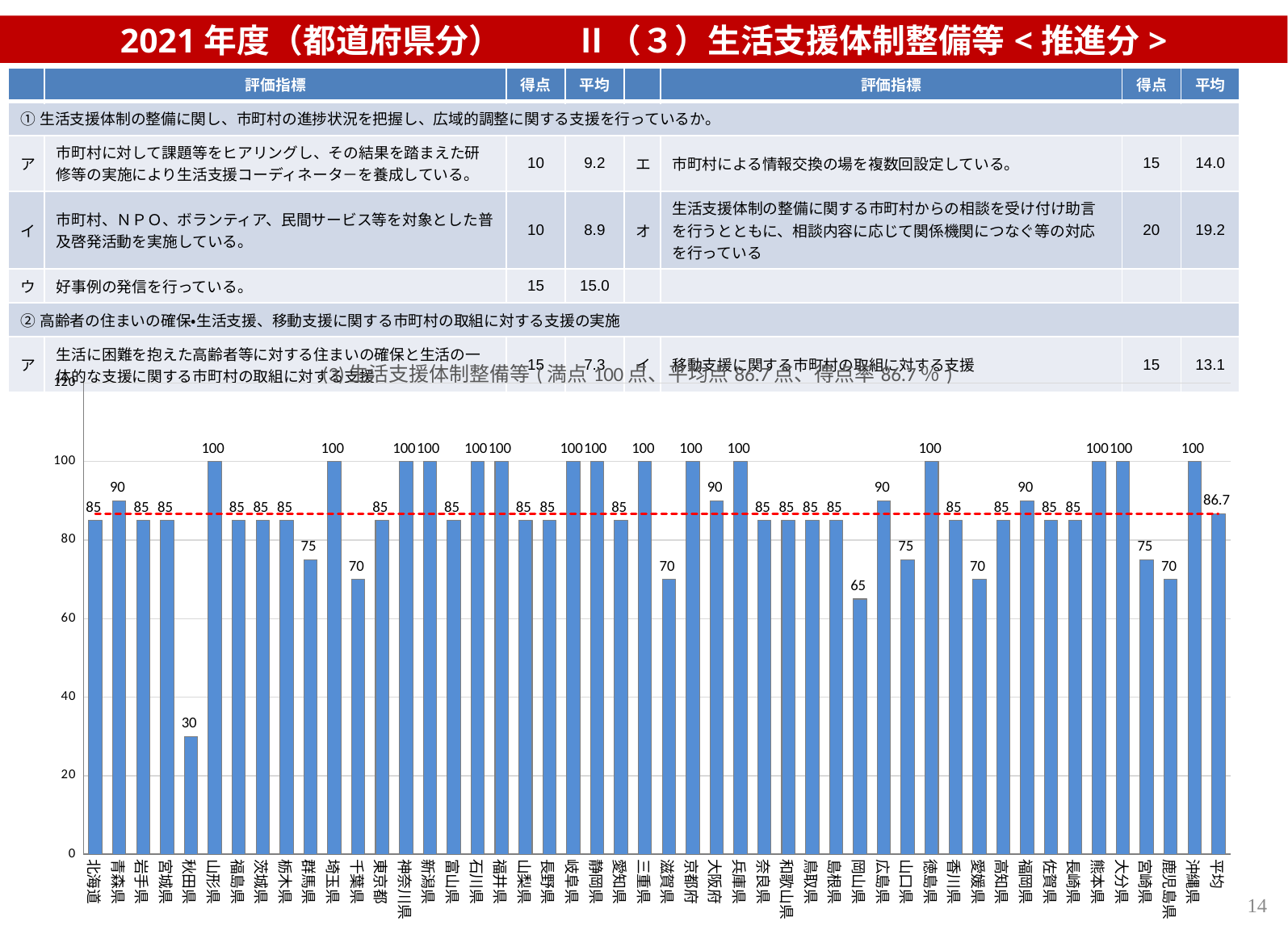
What is the value for 岡山県 in the bar chart? 65 Which category has the lowest value in the bar chart? 秋田県 What value does the red dashed horizontal line across the chart mark? 86.7 Which is larger, the value for 群馬県 or the value for 千葉県? 群馬県 What is the value of the 平均 bar at the far right of the chart? 86.7 What is the difference between the values for 山形県 and 群馬県? 25 Is the value for 滋賀県 greater or less than 80? less What is the value for 大阪府 in the bar chart? 90 What is the value for 秋田県 in the bar chart? 30 How many bars are plotted in the chart, including the 平均 bar? 48 What kind of chart is shown on the slide? bar chart What is the difference between the values for 青森県 and 秋田県? 60